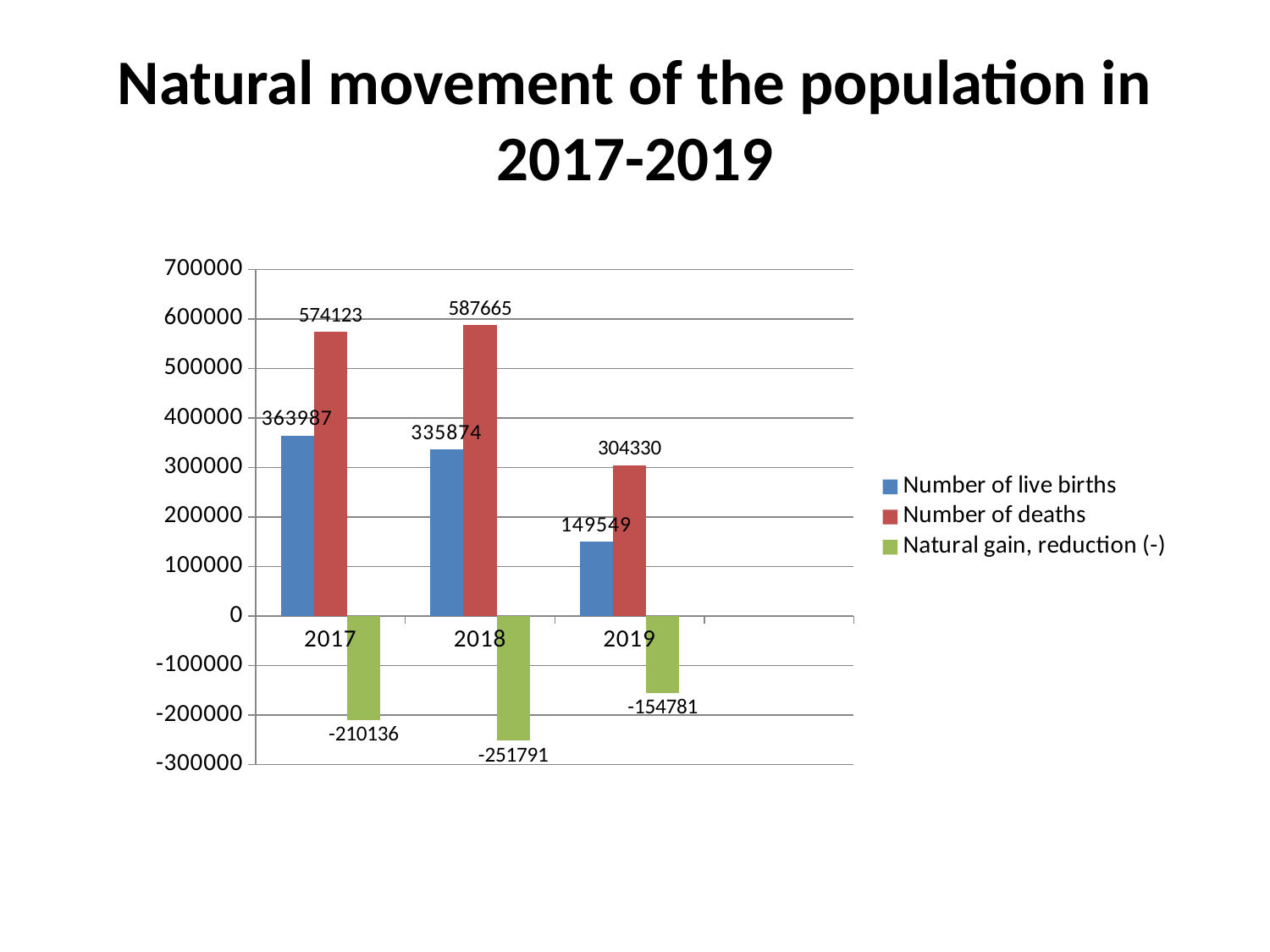
What is the value of Natural gain, reduction (-) for 2019? -154781 How many series does the legend list? 3 Which is larger in 2017: the number of live births or the number of deaths? Number of deaths Do the number of live births rise or fall from 2017 to 2019? Fall In which year is the number of deaths highest? 2018 In which year is the number of live births lowest? 2019 What is the difference between the number of live births in 2017 and in 2018? 28113 How many years are shown on the x axis? 3 What kind of chart is shown on the slide? Bar chart What is the number of live births in 2017? 363987 What is the number of deaths in 2018? 587665 What is the difference between the number of deaths and the number of live births in 2019? 154781